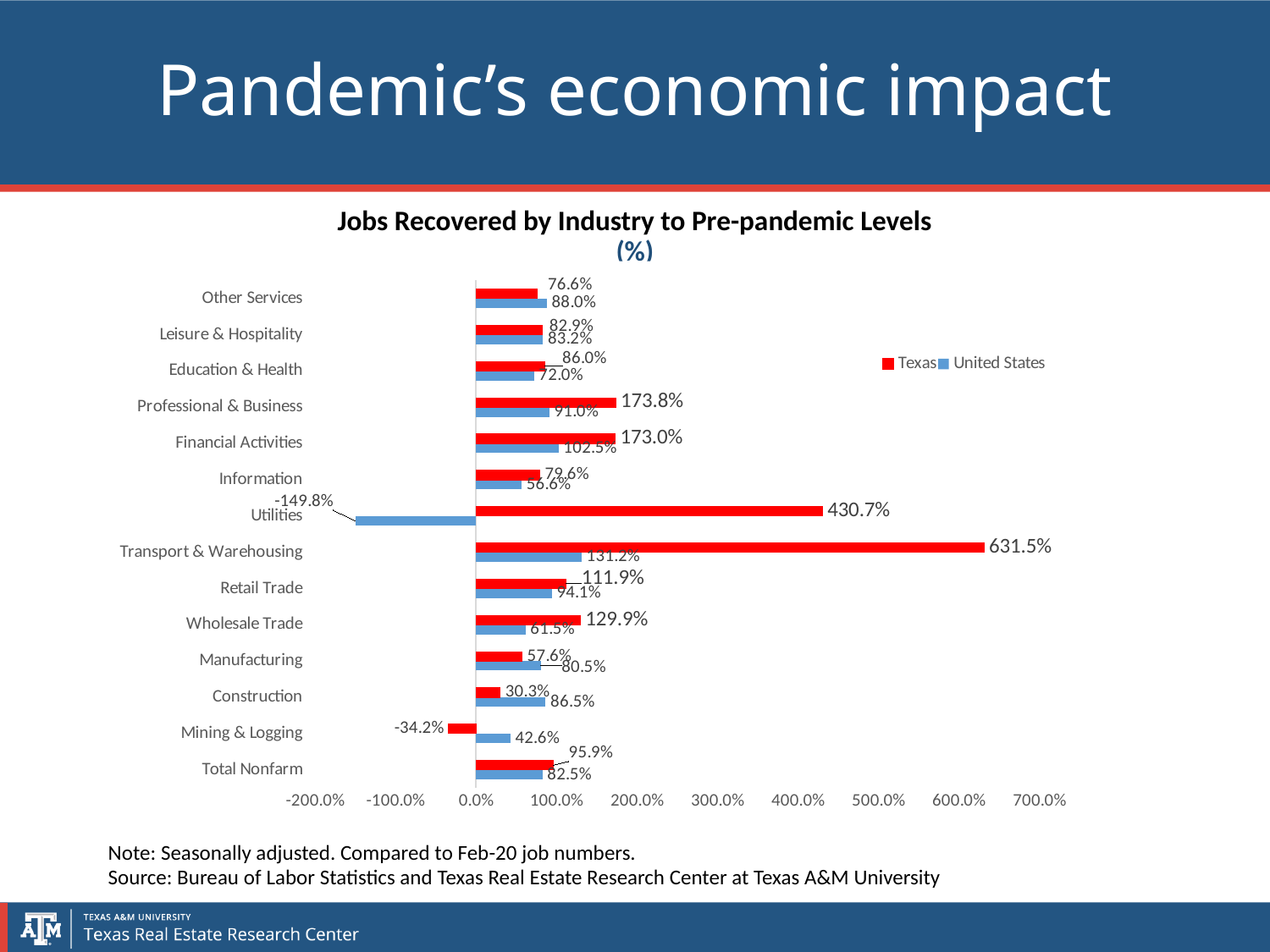
What is the Texas value for Transport & Warehousing? 631.5% What is the United States value for Total Nonfarm? 82.5% For Construction, which is larger: the Texas value or the United States value? United States What is the difference between the Texas and United States values for Education & Health? 14.0 percentage points Which industry has the highest Texas value? Transport & Warehousing What kind of chart is shown on the slide? Bar chart How many industries are shown on the chart? 14 Which industry has the lowest Texas value? Mining & Logging What colour represents Texas in the chart? Red Which industry has the lowest United States value? Utilities What is the Texas value for Mining & Logging? -34.2% How many series does the legend list? 2